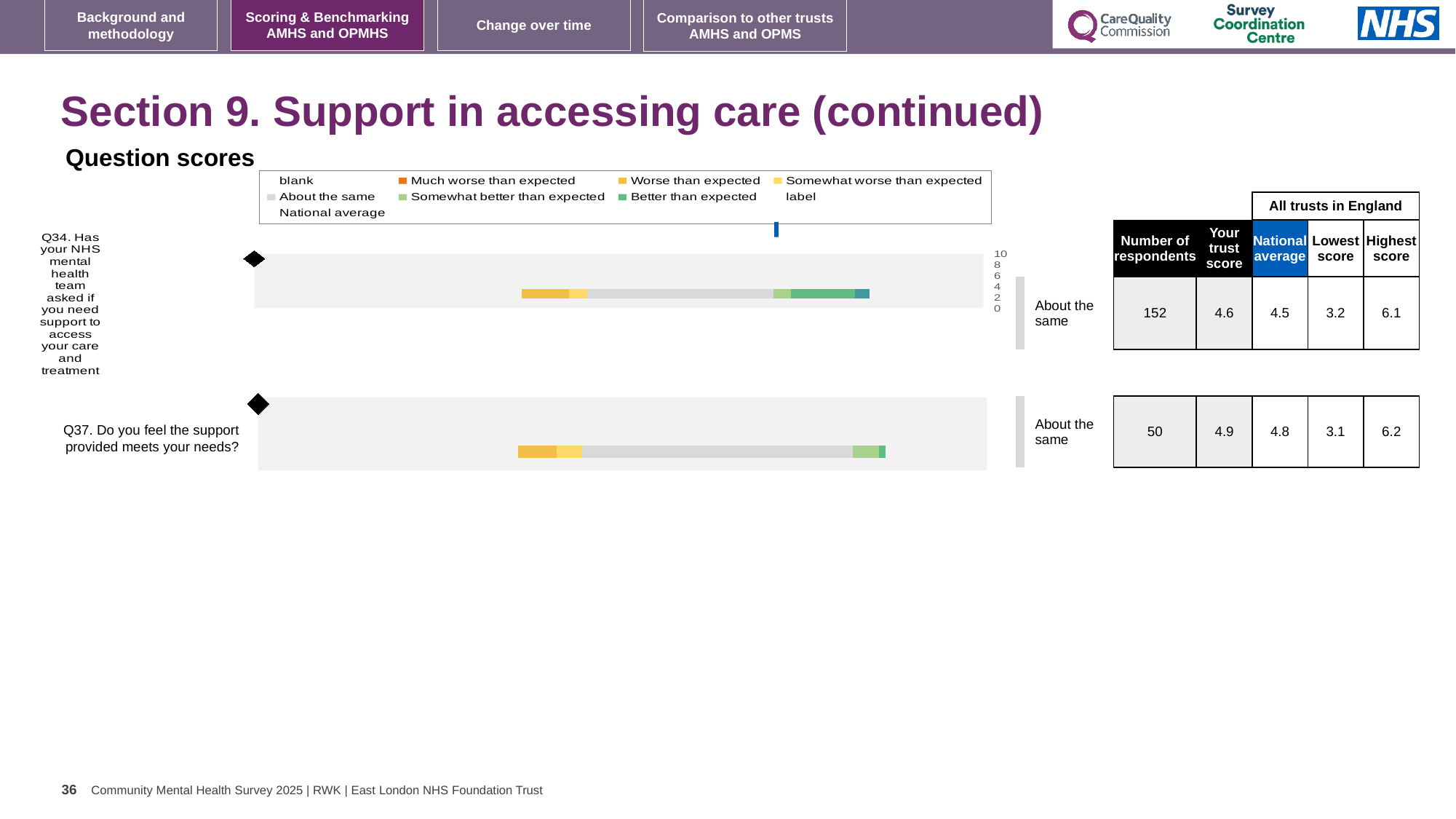
Which question has more respondents, Q34 or Q37? Q34 What is the national average for Q34 in the question scores table? 4.5 What benchmark category is shown next to the bar for Q37 in the question scores chart? About the same How many questions are plotted in the question scores chart? 2 Is the trust score for Q37 higher or lower than the national average for Q37? higher What is the difference between the highest score and the lowest score for Q34? 2.9 What is the trust score for Q37 in the question scores table? 4.9 What is the lowest score across all trusts in England for Q37? 3.1 What is the number of respondents for Q34 in the question scores table? 152 What kind of chart is used to show the question scores on this slide? bar chart What benchmark category is shown next to the bar for Q34 in the question scores chart? About the same Which legend entry in the question scores chart is shown in orange? Much worse than expected